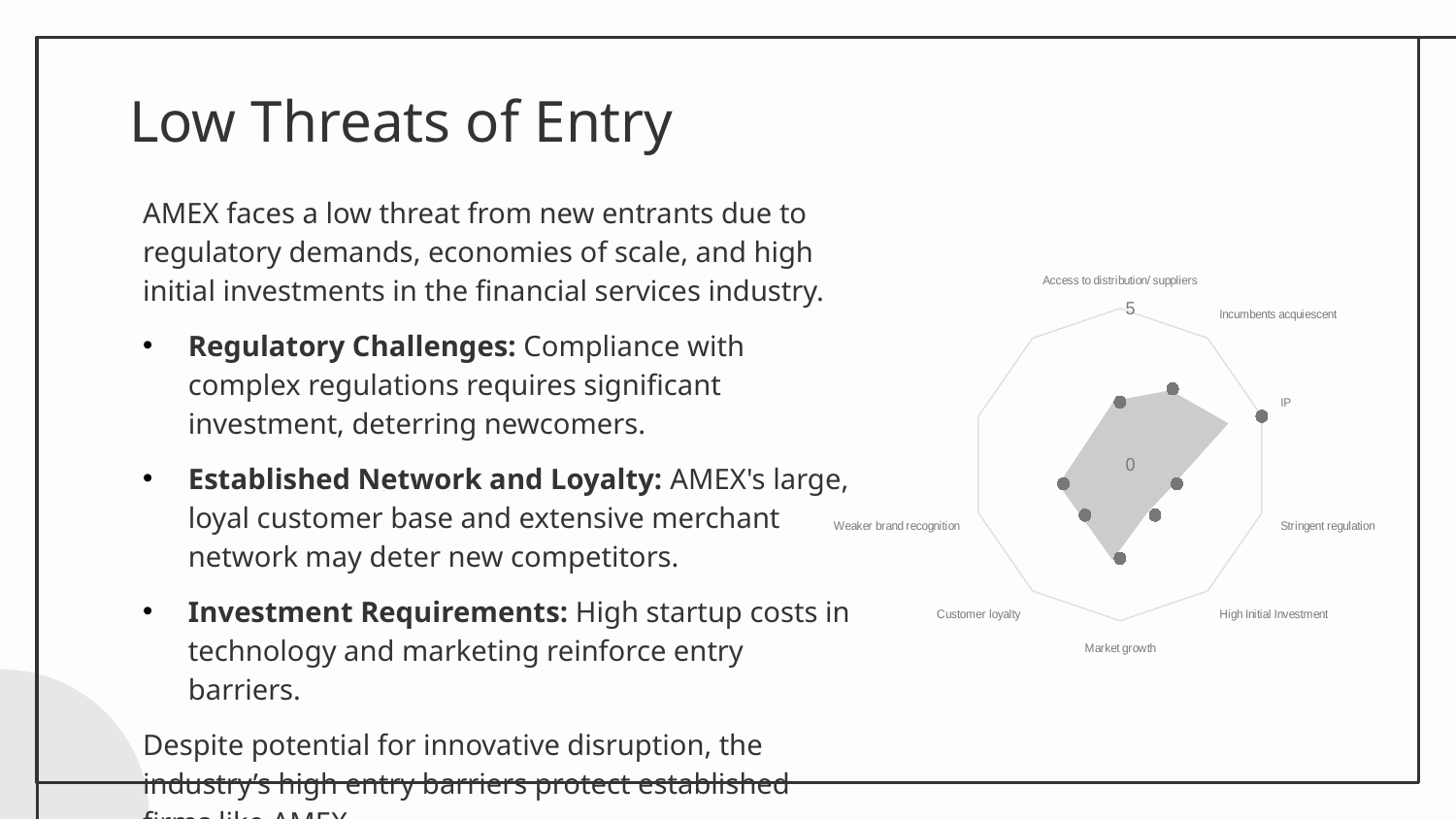
Which is larger on the radar chart, the value for IP or the value for Stringent regulation? IP What kind of chart is shown on the slide? radar chart What is the minimum value shown on the radar chart's axis scale? 0 Which category has the highest value on the radar chart? IP What is the maximum value shown on the radar chart's axis scale? 5 Which is larger on the radar chart, the value for IP or the value for Market growth? IP Which is larger on the radar chart, the value for IP or the value for Weaker brand recognition? IP